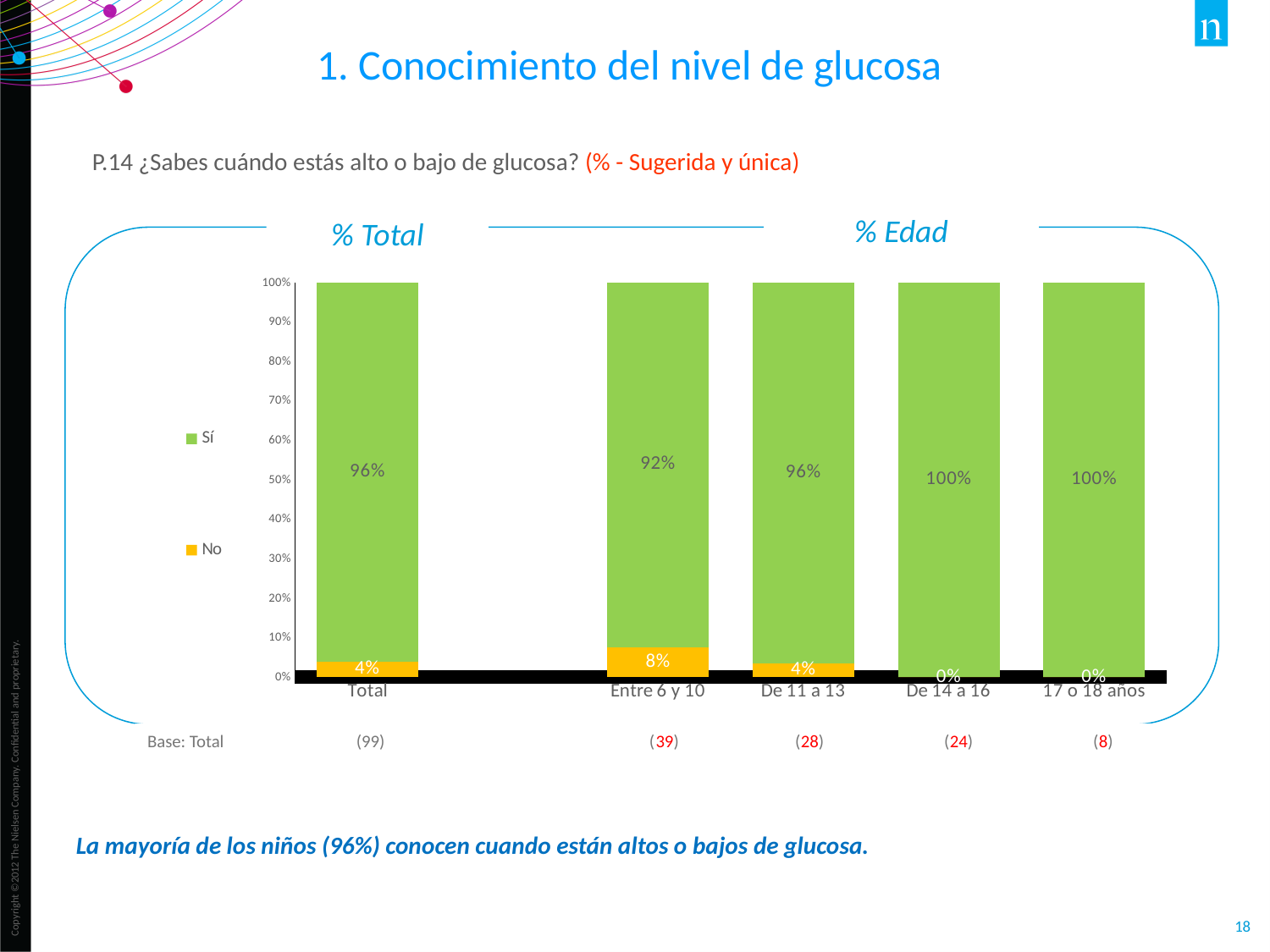
What kind of chart is shown on the slide? Stacked bar chart What is the value of "No" for the "Entre 6 y 10" category? 8% Which category has the lowest value for "Sí"? Entre 6 y 10 How many categories are shown on the x axis of the chart? 5 Which is larger: the "Sí" value for "Entre 6 y 10" or the "Sí" value for "De 11 a 13"? De 11 a 13 Which category has the highest value for "No"? Entre 6 y 10 Which colour represents the "No" series in the chart? Yellow/orange What is the value of "Sí" for the "De 14 a 16" category? 100% What is the difference between the "Sí" value for "De 14 a 16" and the "Sí" value for "Entre 6 y 10"? 8% How many series does the legend list? 2 What is the value of "Sí" for the "Total" category? 96% What is the value of "No" for the "De 11 a 13" category? 4%